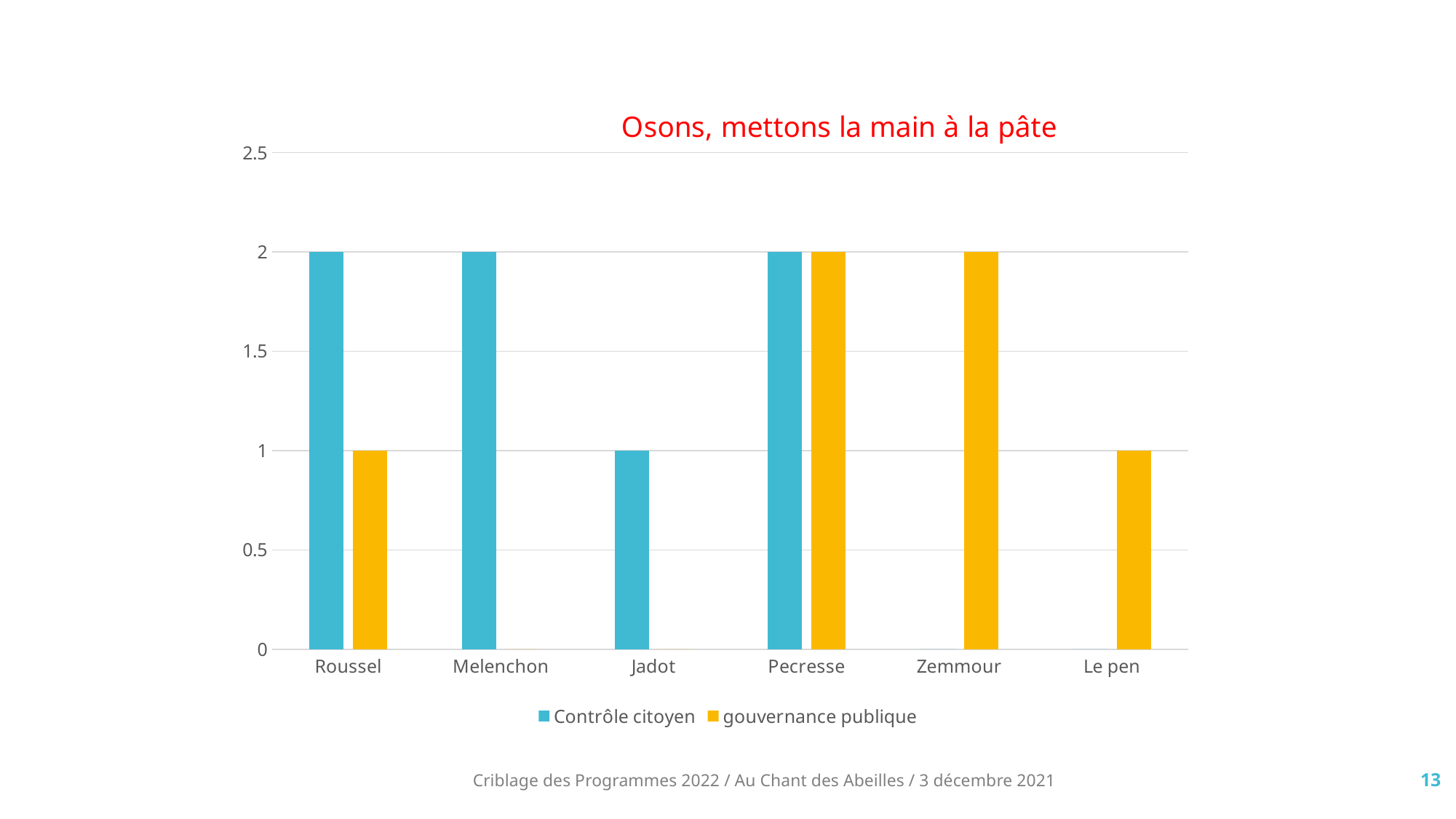
What is the difference between the Contrôle citoyen and gouvernance publique values for Roussel? 1 Which candidate has the lowest Contrôle citoyen value among those with a visible Contrôle citoyen bar? Jadot What is the Contrôle citoyen value for Jadot? 1 How many series does the legend list? 2 What is the title of the chart? Osons, mettons la main à la pâte How many candidates are shown on the x axis? 6 What kind of chart is shown on the slide? bar chart What is the Contrôle citoyen value for Roussel? 2 What is the gouvernance publique value for Roussel? 1 What is the gouvernance publique value for Zemmour? 2 What is the gouvernance publique value for Le pen? 1 Which is larger for Pecresse: Contrôle citoyen or gouvernance publique? They are equal